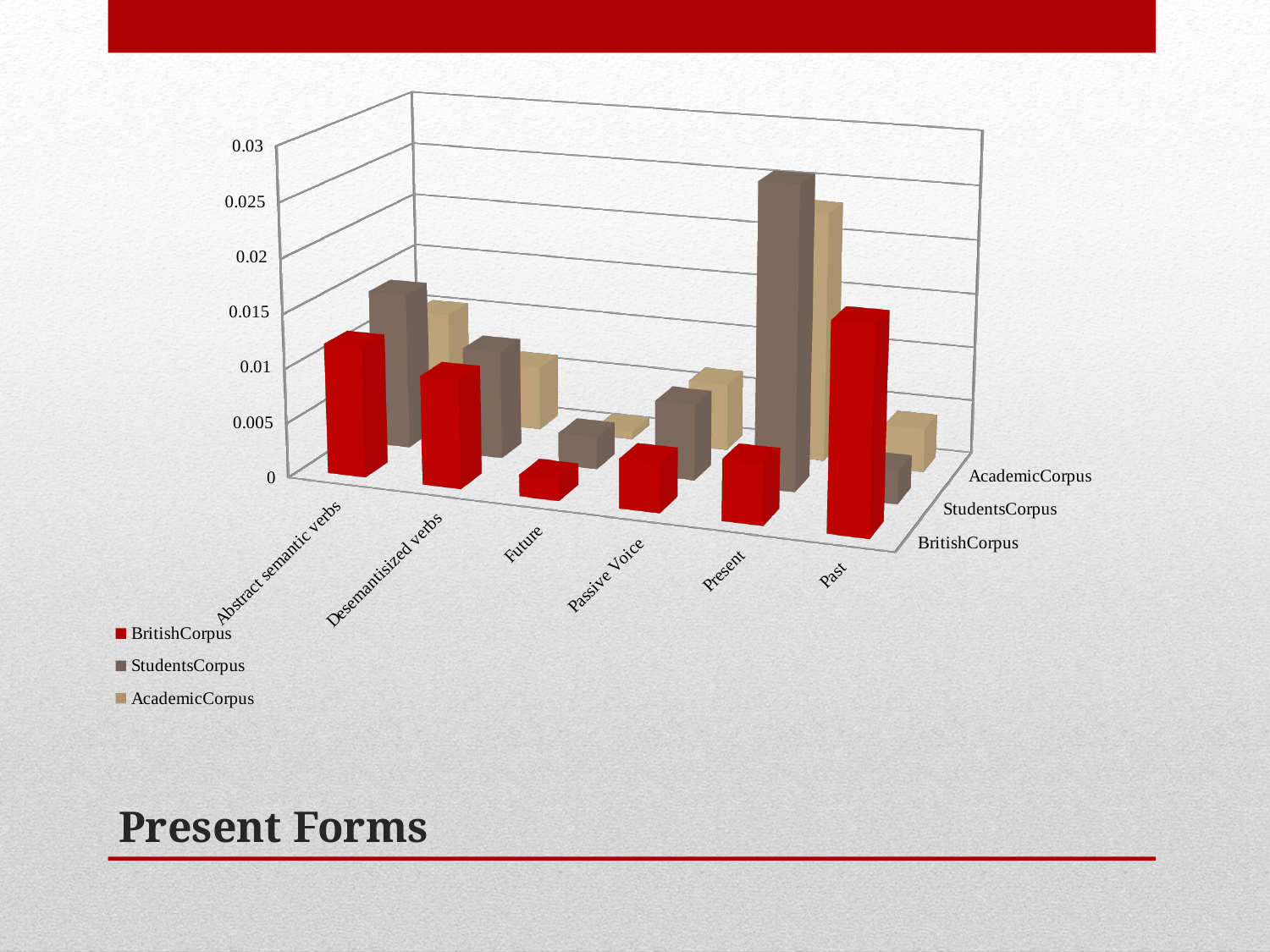
Is the BritishCorpus value for Past greater or less than 0.01? greater Which category has the lowest value for the BritishCorpus series? Future Which category has the highest value for the AcademicCorpus series? Present Which series is shown in red in the legend? BritishCorpus What kind of chart is shown on the slide? bar chart Which category has the highest value for the BritishCorpus series? Past For the StudentsCorpus series, which is larger: the value for Present or the value for Past? Present How many categories are shown on the x axis? 6 Which category has the highest value for the StudentsCorpus series? Present Is the StudentsCorpus value for Present greater or less than 0.02? greater How many series does the legend list? 3 Is the BritishCorpus value for Future greater or less than 0.005? less